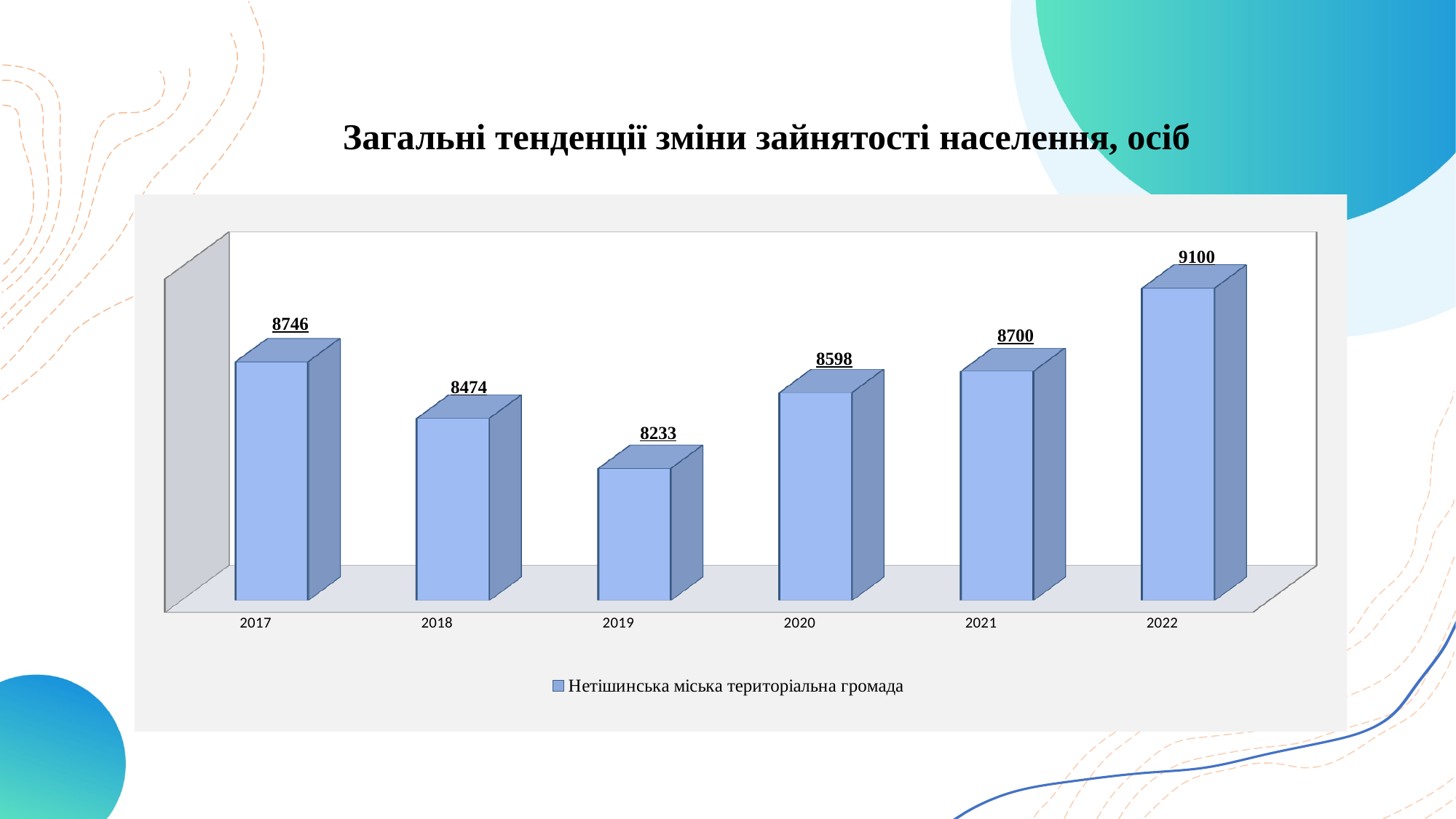
What is the legend entry for the series? Нетішинська міська територіальна громада What is the difference between the values for 2022 and 2021? 400 What is the difference between the values for 2017 and 2018? 272 What is the value for 2017? 8746 Which year has the lowest value? 2019 Which year has the highest value? 2022 How many series does the legend list? 1 How many years are shown on the x axis? 6 What kind of chart is shown? bar chart What is the value for 2022? 9100 Which is larger, the value for 2020 or the value for 2017? 2017 What is the value for 2019? 8233